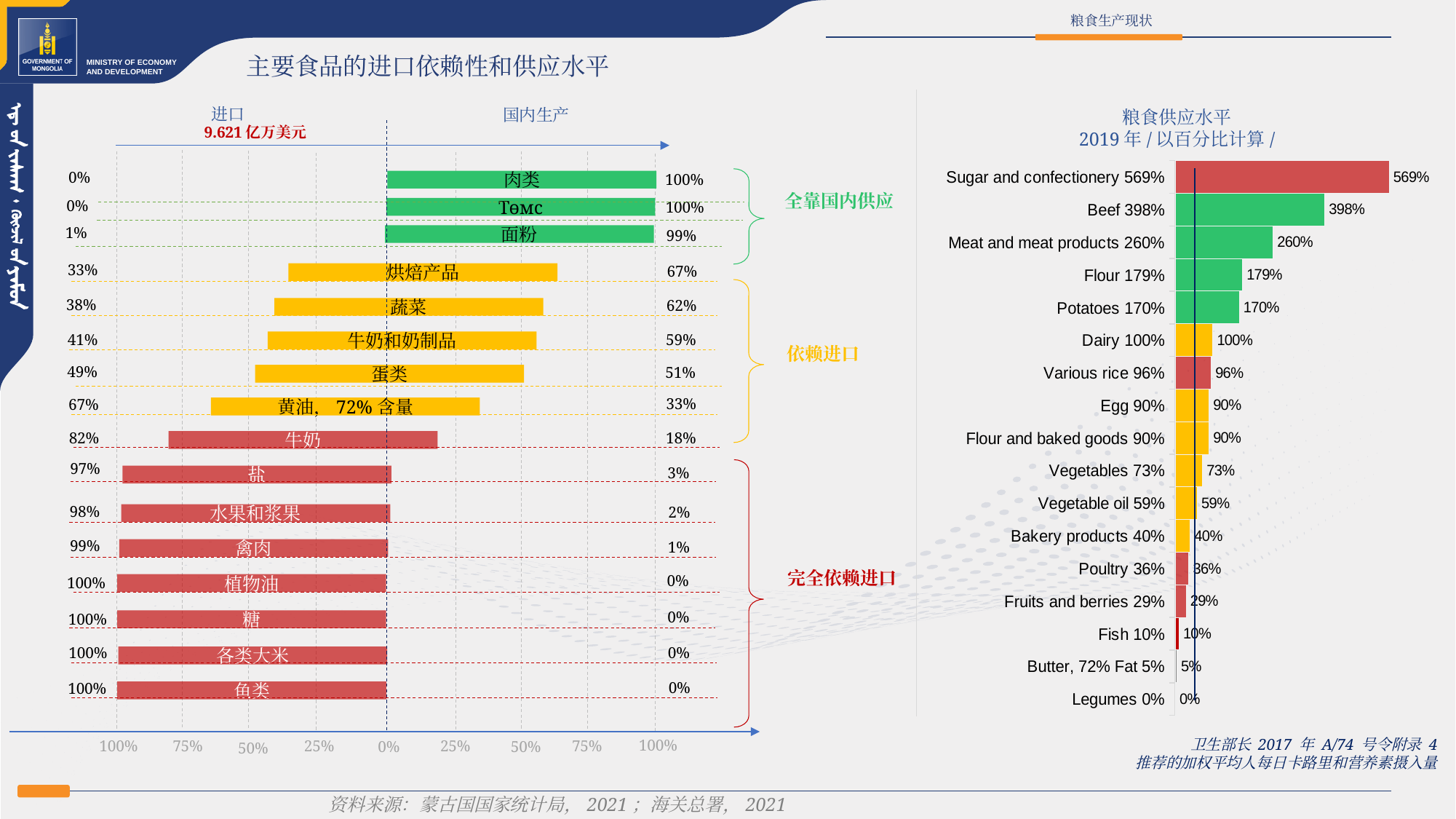
In the right chart (粮食供应水平 2019年), what is the difference between the values for Flour and Potatoes? 9% In the right chart (粮食供应水平 2019年), which category has the lowest value? Legumes In the left chart (主要食品的进口依赖性和供应水平), what is the import (进口) share for 蛋类? 49% In the right chart (粮食供应水平 2019年), what is the value for Fish? 10% In the left chart (主要食品的进口依赖性和供应水平), what is the total import value shown in red above the 进口 axis? 9.621 亿万美元 In the left chart (主要食品的进口依赖性和供应水平), what is the domestic production (国内生产) share for 牛奶? 18% In the right chart (粮食供应水平 2019年), how many categories are plotted? 17 In the right chart (粮食供应水平 2019年), what is the value for Beef? 398% In the right chart (粮食供应水平 2019年), which category has the highest value? Sugar and confectionery In the left chart (主要食品的进口依赖性和供应水平), how many food categories are plotted? 16 What kind of chart is the right chart (粮食供应水平 2019年)? Bar chart In the right chart (粮食供应水平 2019年), which is larger, the value for Vegetables or the value for Vegetable oil? Vegetables